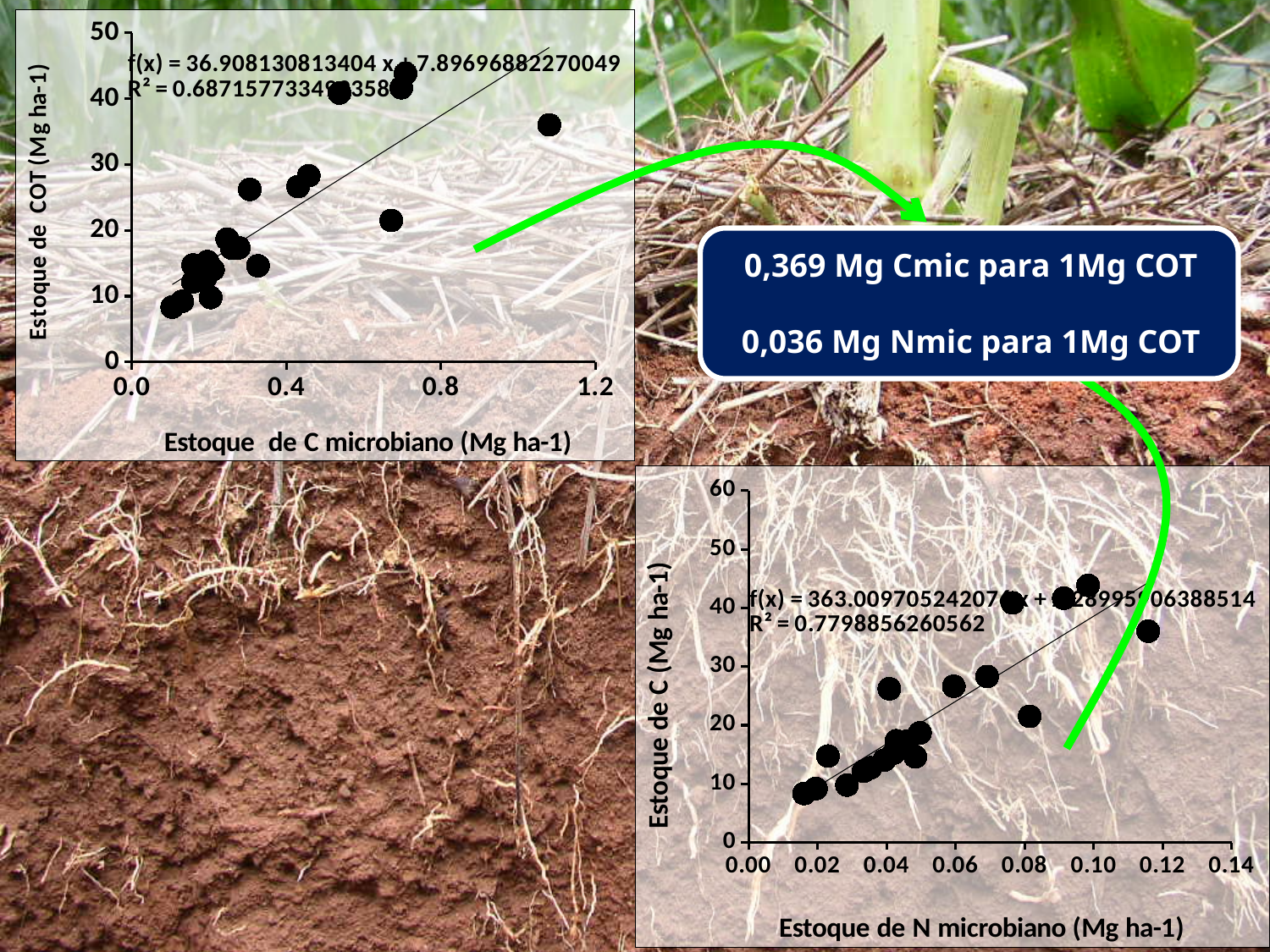
What is the highest tick value shown on the x axis of the top-left chart? 1.2 What is the x-axis label of the top-left chart? Estoque de C microbiano (Mg ha-1) What is the R² value shown on the bottom-right chart? 0.7798856260562 What kind of chart is the top-left chart on the slide? scatter chart What is the x-axis label of the bottom-right chart? Estoque de N microbiano (Mg ha-1) In the top-left chart, do the values of Estoque de COT generally rise or fall as Estoque de C microbiano increases? rise In the bottom-right chart, is the value of Estoque de C for the point with the largest Estoque de N microbiano (near 0.12) greater or less than 30? greater What kind of chart is the bottom-right chart on the slide? scatter chart What is the highest tick value shown on the y axis of the bottom-right chart? 60 In the bottom-right chart, do the values of Estoque de C generally rise or fall as Estoque de N microbiano increases? rise In the top-left chart, is the value of Estoque de COT for the point with the largest Estoque de C microbiano (near 1.1) greater or less than 30? greater In the top-left chart, is the value of Estoque de COT for the point at about 0.65 on the x axis greater or less than 30? less